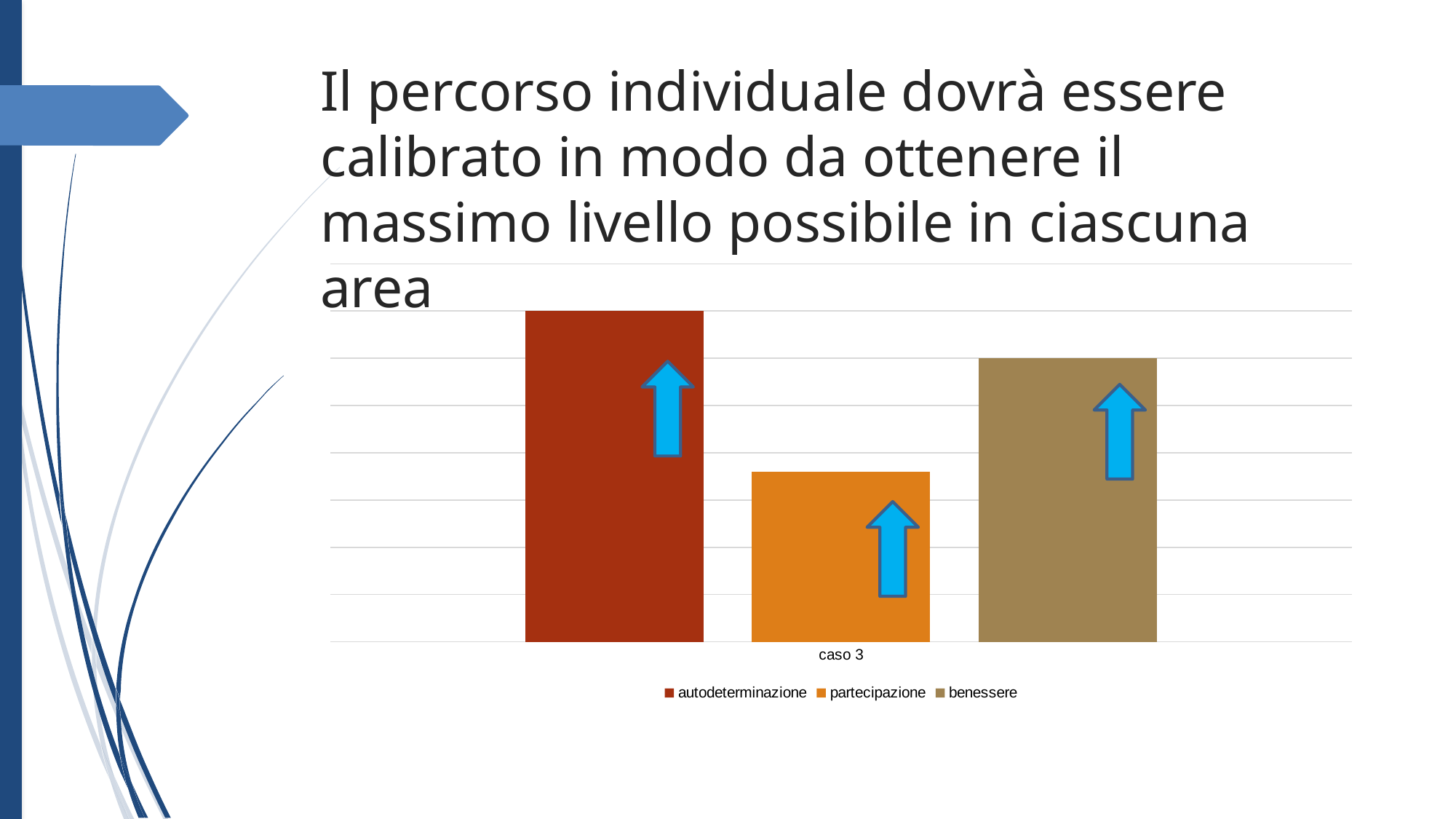
Which is larger for caso 3, autodeterminazione or partecipazione? autodeterminazione Which is larger for caso 3, autodeterminazione or benessere? autodeterminazione What is the name of the category shown on the x axis? caso 3 What colour is the bar for the partecipazione series? orange Which is larger for caso 3, partecipazione or benessere? benessere How many series does the chart legend list? 3 Which series has the shortest bar for caso 3? partecipazione Which series has the tallest bar for caso 3? autodeterminazione How many categories are shown on the x axis of the chart? 1 What kind of chart is shown on the slide? bar chart